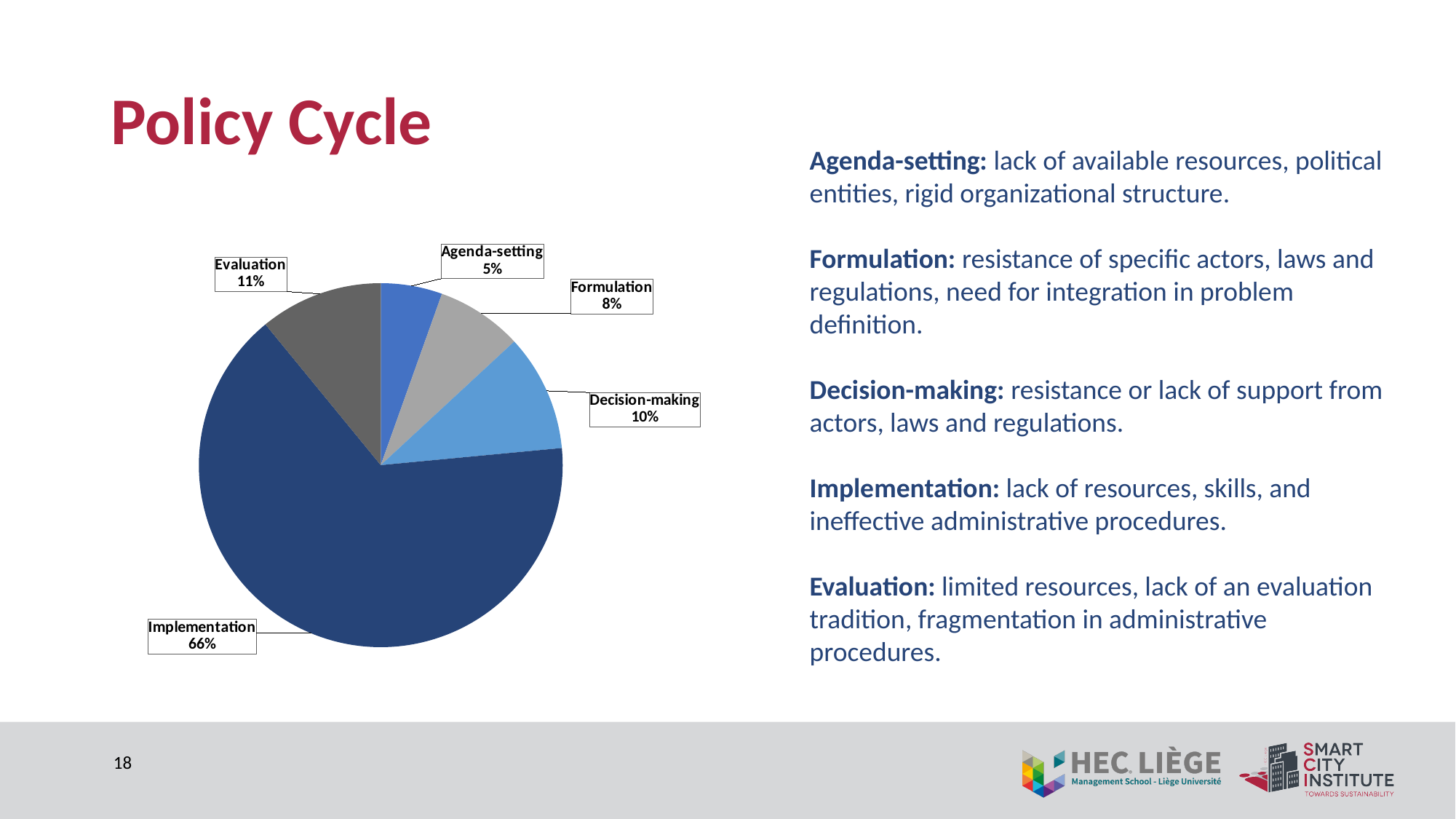
Which is larger, the slice for Formulation or the slice for Evaluation? Evaluation What share of the pie does Implementation account for? 66% Which policy cycle stage has the largest slice of the pie? Implementation What percentage is shown for Decision-making? 10% What percentage is shown for Evaluation? 11% What kind of chart is shown on the slide? Pie chart What is the title of the slide containing the chart? Policy Cycle What percentage is shown for Agenda-setting? 5% Which policy cycle stage has the smallest slice of the pie? Agenda-setting How many slices does the pie chart have? 5 What is the difference in percentage points between Decision-making and Formulation? 2 What is the difference in percentage points between Implementation and Evaluation? 55